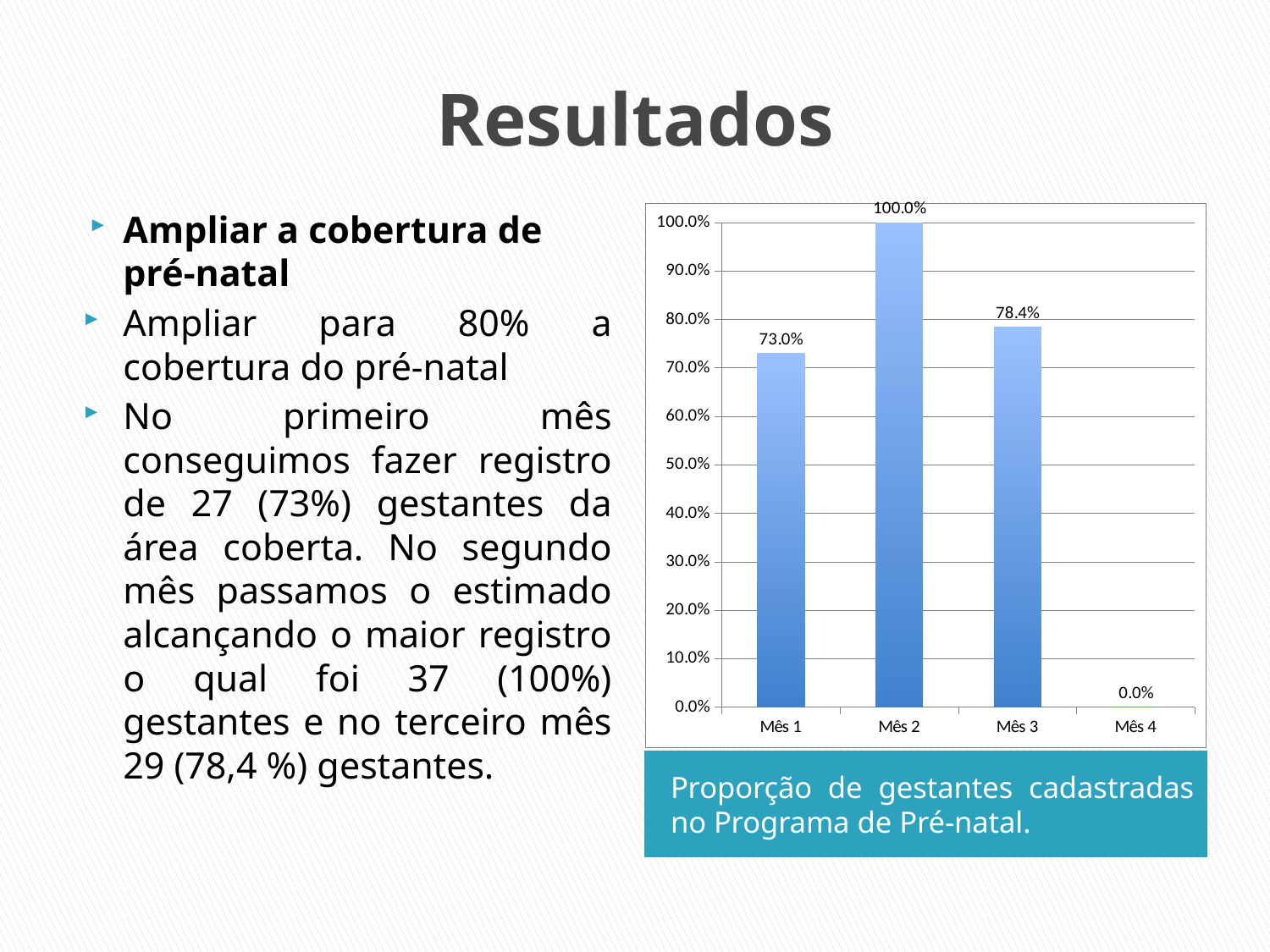
Which month has the highest value? Mês 2 How many months (categories) are shown on the x axis? 4 Which month has the lowest value? Mês 4 What is the caption below the chart? Proporção de gestantes cadastradas no Programa de Pré-natal. What is the difference between the values for Mês 3 and Mês 1? 5.4% What kind of chart is shown on the slide? bar chart Is the value for Mês 1 greater or less than 80%? less Which is larger, the value for Mês 1 or the value for Mês 3? Mês 3 What is the value for Mês 1? 73.0% What is the value for Mês 4? 0.0% What is the value for Mês 3? 78.4% What is the difference between the values for Mês 2 and Mês 1? 27.0%